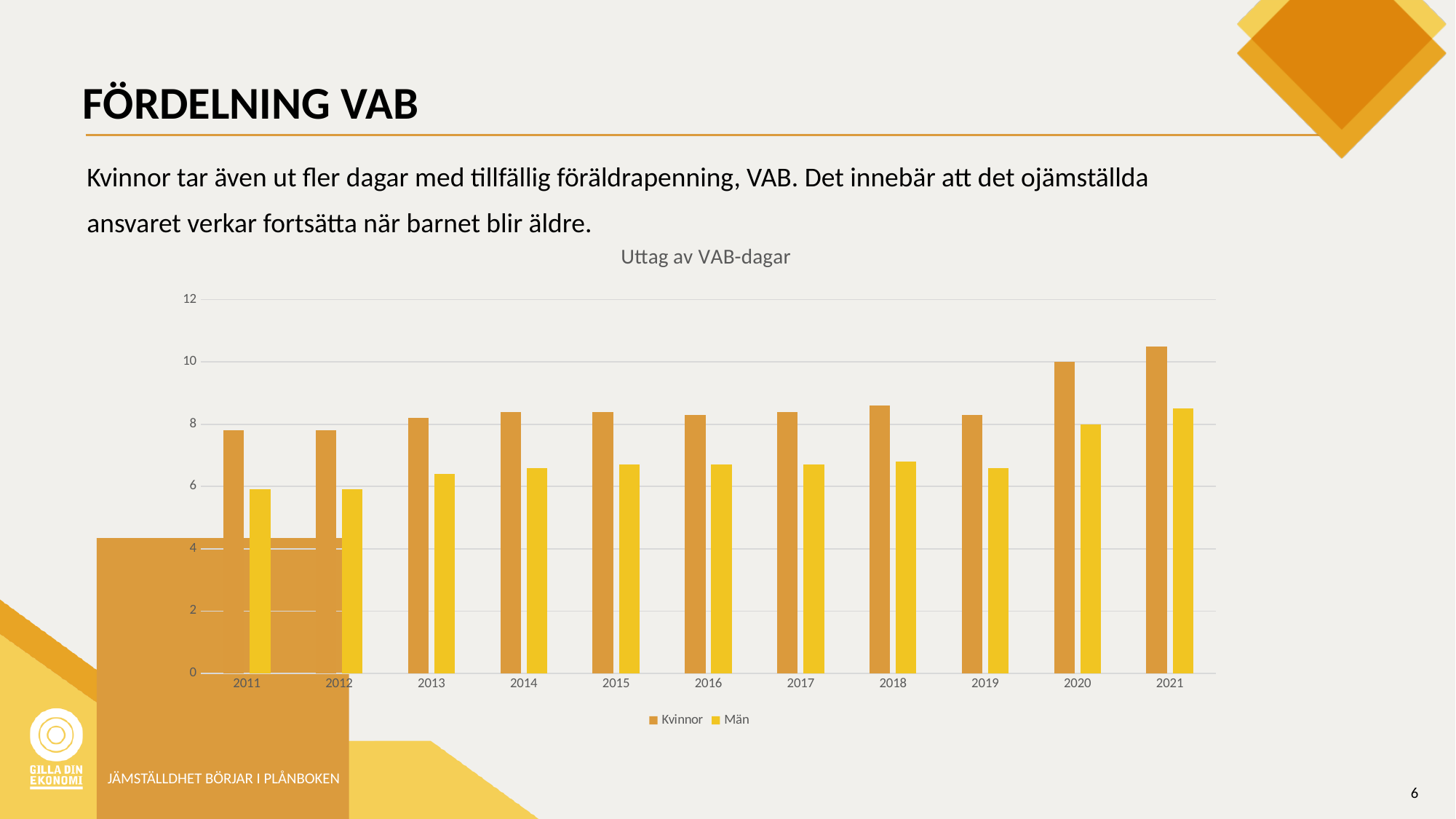
Is the value for Kvinnor in 2011 greater or less than 8? less What kind of chart is shown on the slide? bar chart In which year is the value for Män highest? 2021 In which year is the value for Kvinnor highest? 2021 In 2016, which is larger, the value for Kvinnor or the value for Män? Kvinnor Is the value for Män in 2021 greater or less than 8? greater Is the value for Kvinnor in 2021 greater or less than 10? greater What is the title of the chart? Uttag av VAB-dagar How many years are shown on the x axis of the chart? 11 How many series does the legend list? 2 Does the value for Män rise or fall overall from 2011 to 2021? rise